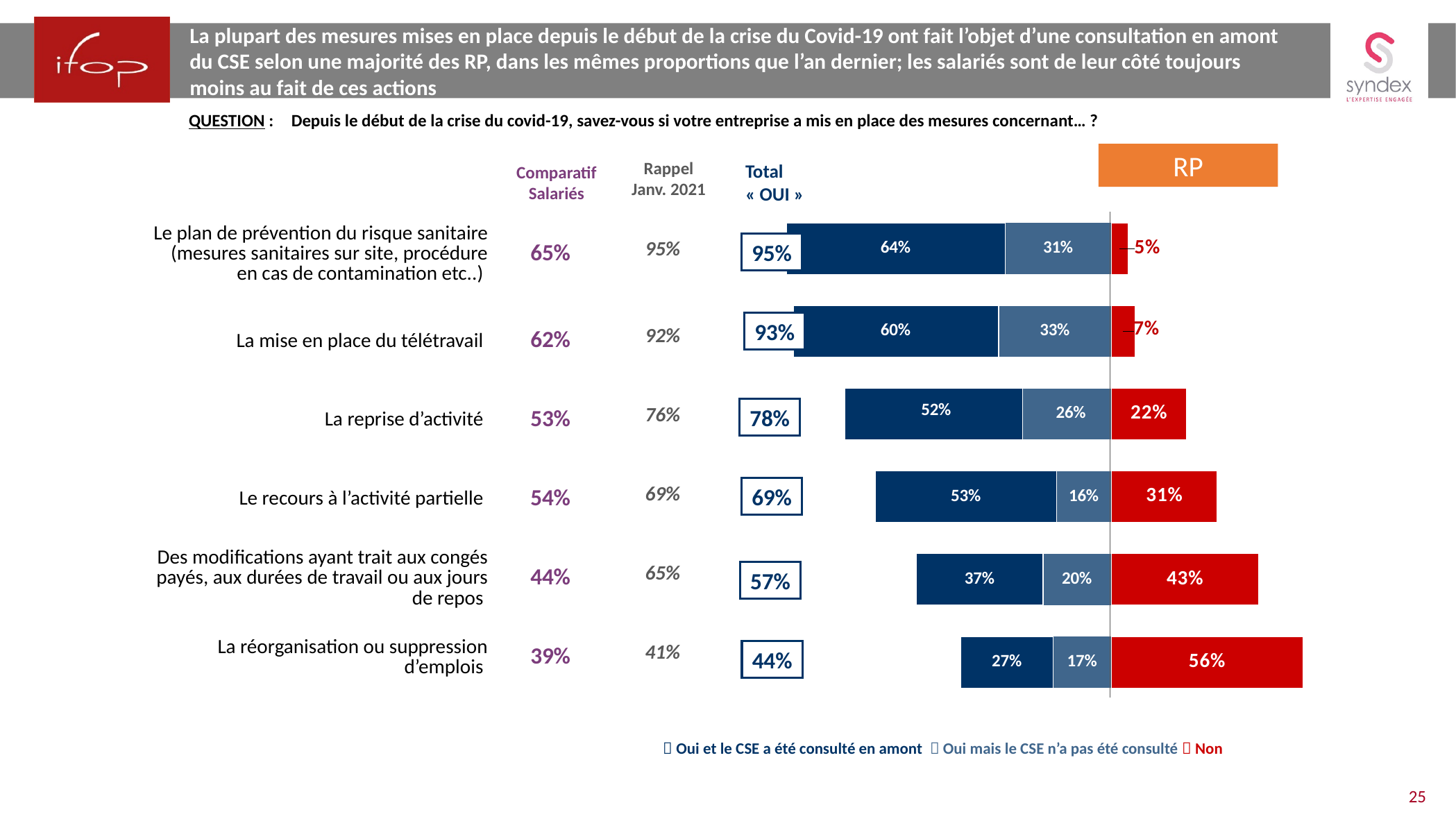
Which category has the lowest "Oui et le CSE a été consulté en amont" value? La réorganisation ou suppression d'emplois What is the difference between the "Non" values for "La reprise d'activité" and "Le plan de prévention du risque sanitaire"? 17% What is the value of "Oui et le CSE a été consulté en amont" for "La mise en place du télétravail"? 60% What is the Total « OUI » value for "Le recours à l'activité partielle"? 69% Which is larger: the "Oui et le CSE a été consulté en amont" value for "La reprise d'activité" or for "Des modifications ayant trait aux congés payés, aux durées de travail ou aux jours de repos"? La reprise d'activité How many categories (measures) are plotted in the chart? 6 Which colour represents the "Non" series in the chart? red What kind of chart is shown on the slide? stacked bar chart Which category has the highest "Non" value? La réorganisation ou suppression d'emplois What is the "Non" value for "La réorganisation ou suppression d'emplois"? 56% What is the value of "Oui mais le CSE n'a pas été consulté" for "Le recours à l'activité partielle"? 16% How many series does the legend list? 3